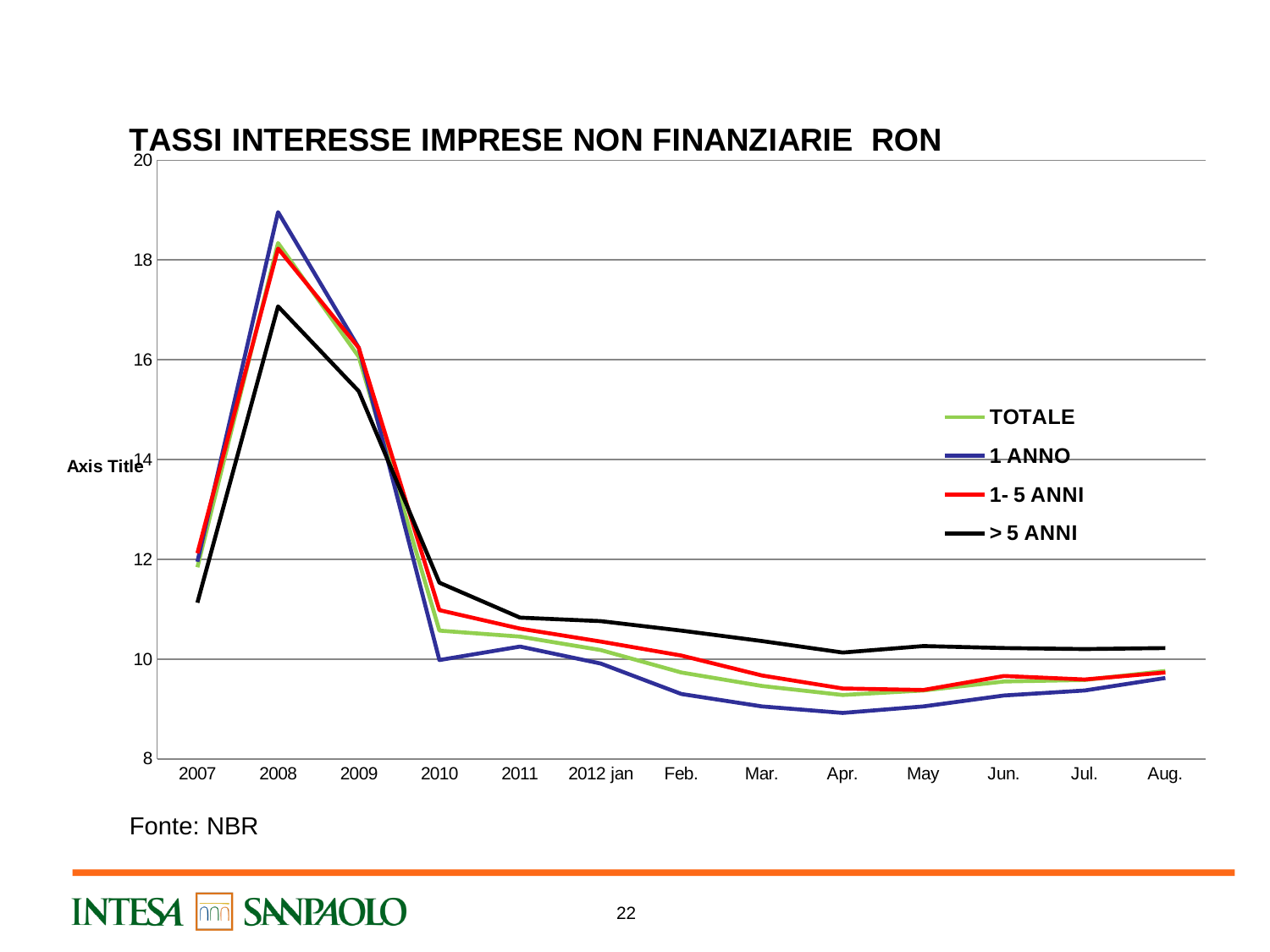
Is the value for 1 ANNO in 2008 greater or less than 18? greater Which series has the lowest value in 2007? > 5 ANNI Is the value for > 5 ANNI in 2007 greater or less than 12? less What kind of chart is shown on the slide? line chart In 2008, which is larger: 1 ANNO or > 5 ANNI? 1 ANNO What is the title of the chart? TASSI INTERESSE IMPRESE NON FINANZIARIE RON Which series has the highest value in Aug.? > 5 ANNI In which year does the 1 ANNO series reach its highest value? 2008 Is the value for 1 ANNO in Apr. greater or less than 10? less Does the 1 ANNO series rise or fall from 2008 to 2010? fall How many series does the legend list? 4 How many points are plotted along the x axis for each series? 13